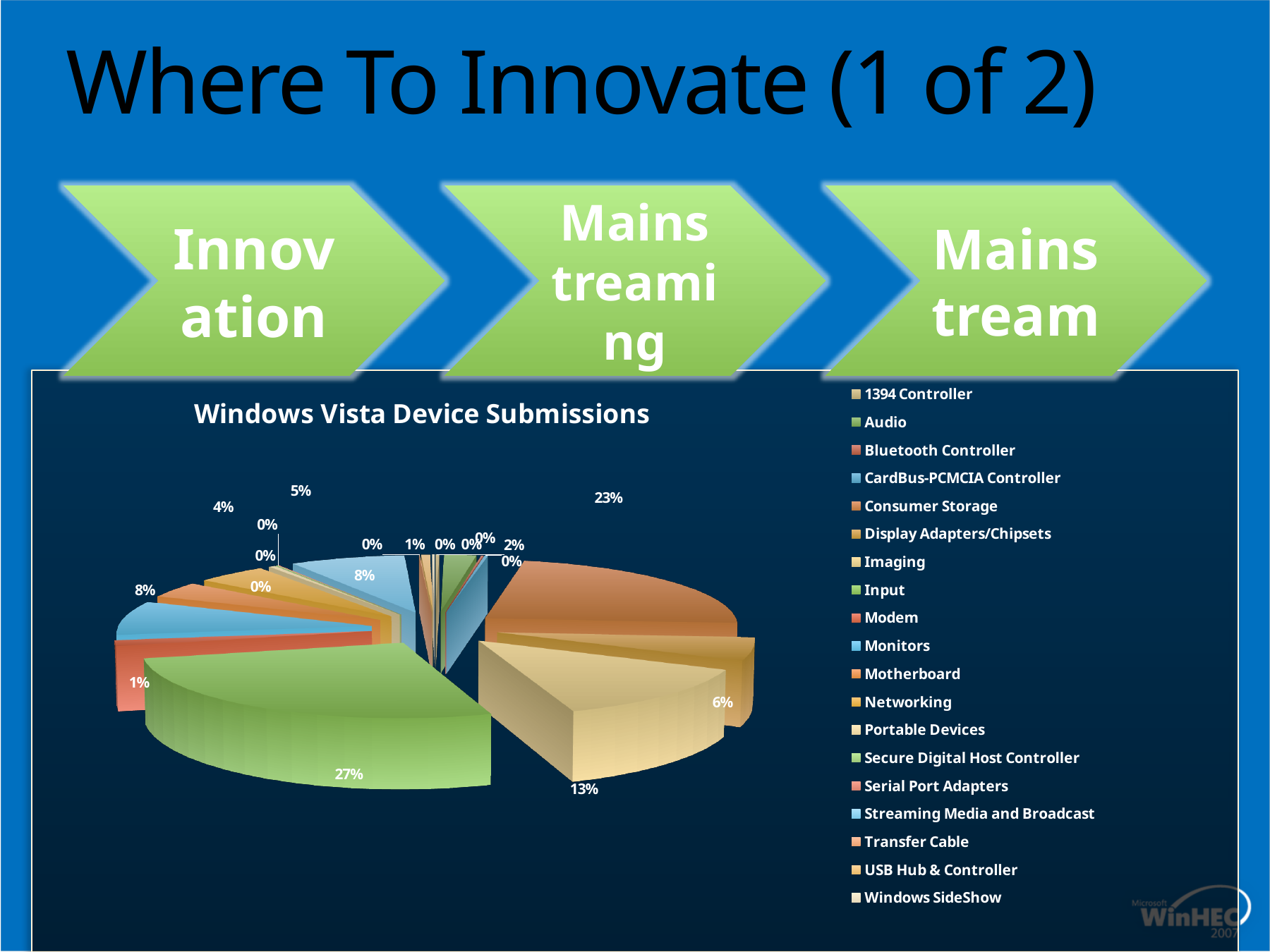
What kind of chart is shown on the slide? pie chart Is the largest slice of the Windows Vista Device Submissions pie chart greater or less than 25%? greater What is the difference between the largest slice label (27%) and the second-largest slice label (23%) on the pie chart? 4 percentage points What is the title of the chart on the slide? Windows Vista Device Submissions How many categories does the legend of the Windows Vista Device Submissions chart list? 19 Which is larger on the pie chart: the slice labelled 13% or the slice labelled 6%? the 13% slice What is the second-largest percentage labelled on the Windows Vista Device Submissions pie chart? 23% What is the smallest non-zero percentage labelled on the Windows Vista Device Submissions pie chart? 1% What is the largest percentage labelled on the Windows Vista Device Submissions pie chart? 27% What is the first category listed in the legend of the Windows Vista Device Submissions chart? 1394 Controller